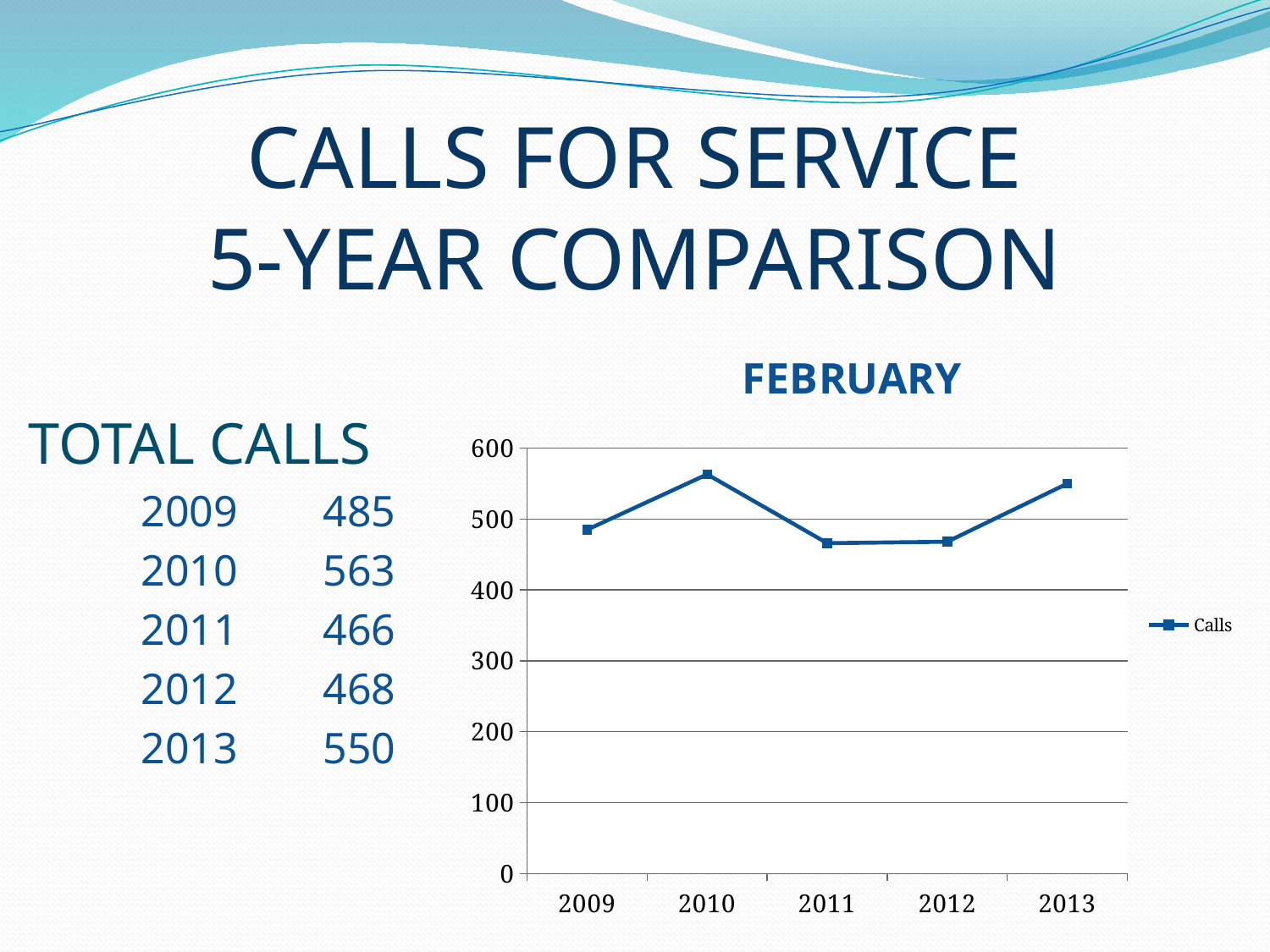
Is the value for 2011 greater or less than 500? less Do the calls rise or fall from 2010 to 2011? fall What is the value for 2013 in the FEBRUARY chart? 550 What is the value for 2010 in the FEBRUARY chart? 563 What is the legend entry of the FEBRUARY chart? Calls How many years are plotted in the FEBRUARY chart? 5 Which year has the highest number of calls in the FEBRUARY chart? 2010 What is the difference between the calls in 2013 and 2011? 84 Which year has more calls, 2009 or 2013? 2013 What kind of chart is shown on the slide? line chart How many series does the legend of the FEBRUARY chart list? 1 What is the difference between the calls in 2010 and 2009? 78